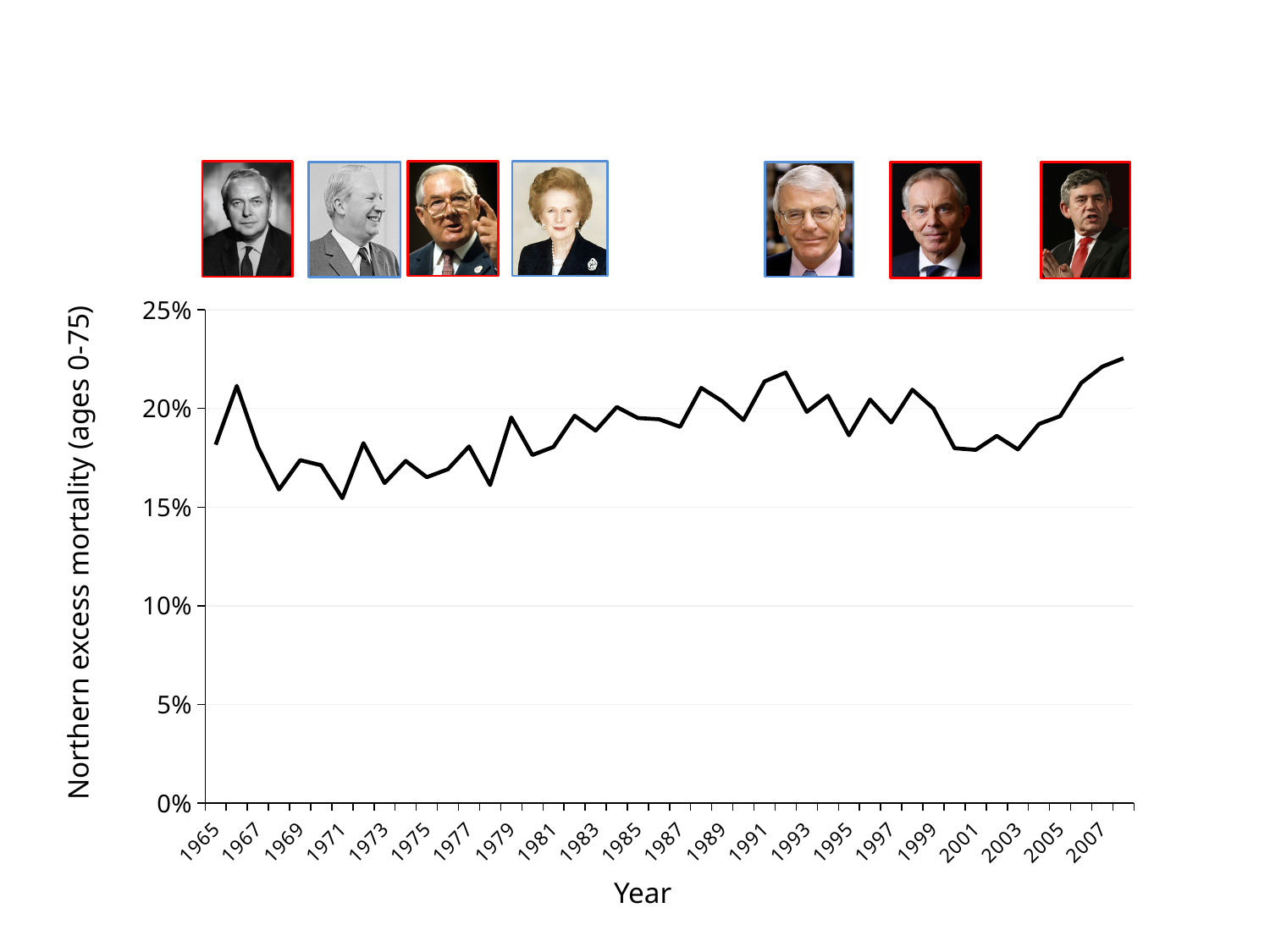
Which year has the larger value, 1966 or 1968? 1966 What is the label of the horizontal axis? Year Is the value for 2001 greater or less than 20%? less Do the values rise or fall between 1998 and 2001? fall What kind of chart is shown on the slide? line chart Which year has the larger value, 2001 or 2008? 2008 Is the value for 1965 greater or less than 15%? greater What is the label of the vertical axis? Northern excess mortality (ages 0-75) Do the values rise or fall between 2003 and 2008? rise Is the value for 2008 greater or less than 20%? greater